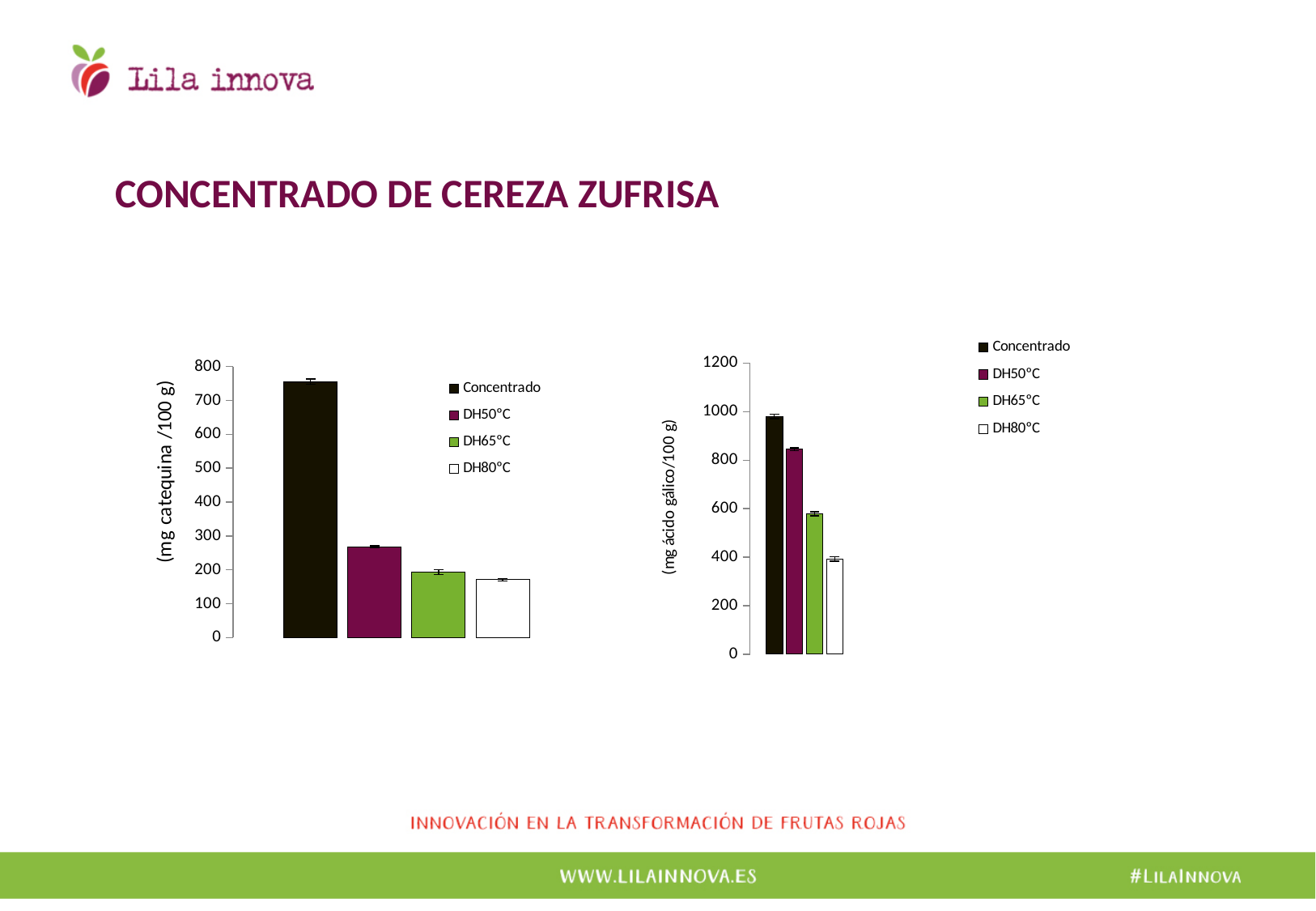
What kind of chart is the right chart (mg ácido gálico/100 g)? bar chart In the left chart (mg catequina /100 g), which is larger, the value for DH50°C or the value for DH65°C? DH50°C In the left chart (mg catequina /100 g), which series has the highest value? Concentrado In the right chart (mg ácido gálico/100 g), which series has the highest value? Concentrado In the left chart (mg catequina /100 g), is the value for DH50°C greater or less than 300? less In the left chart (mg catequina /100 g), which series has the lowest value? DH80°C How many series does the legend of the left chart (mg catequina /100 g) list? 4 What kind of chart is the left chart (mg catequina /100 g)? bar chart In the right chart (mg ácido gálico/100 g), do the values rise or fall from Concentrado to DH80°C? fall In the left chart (mg catequina /100 g), is the value for Concentrado greater or less than 700? greater What is the y-axis label of the right chart? (mg ácido gálico/100 g)